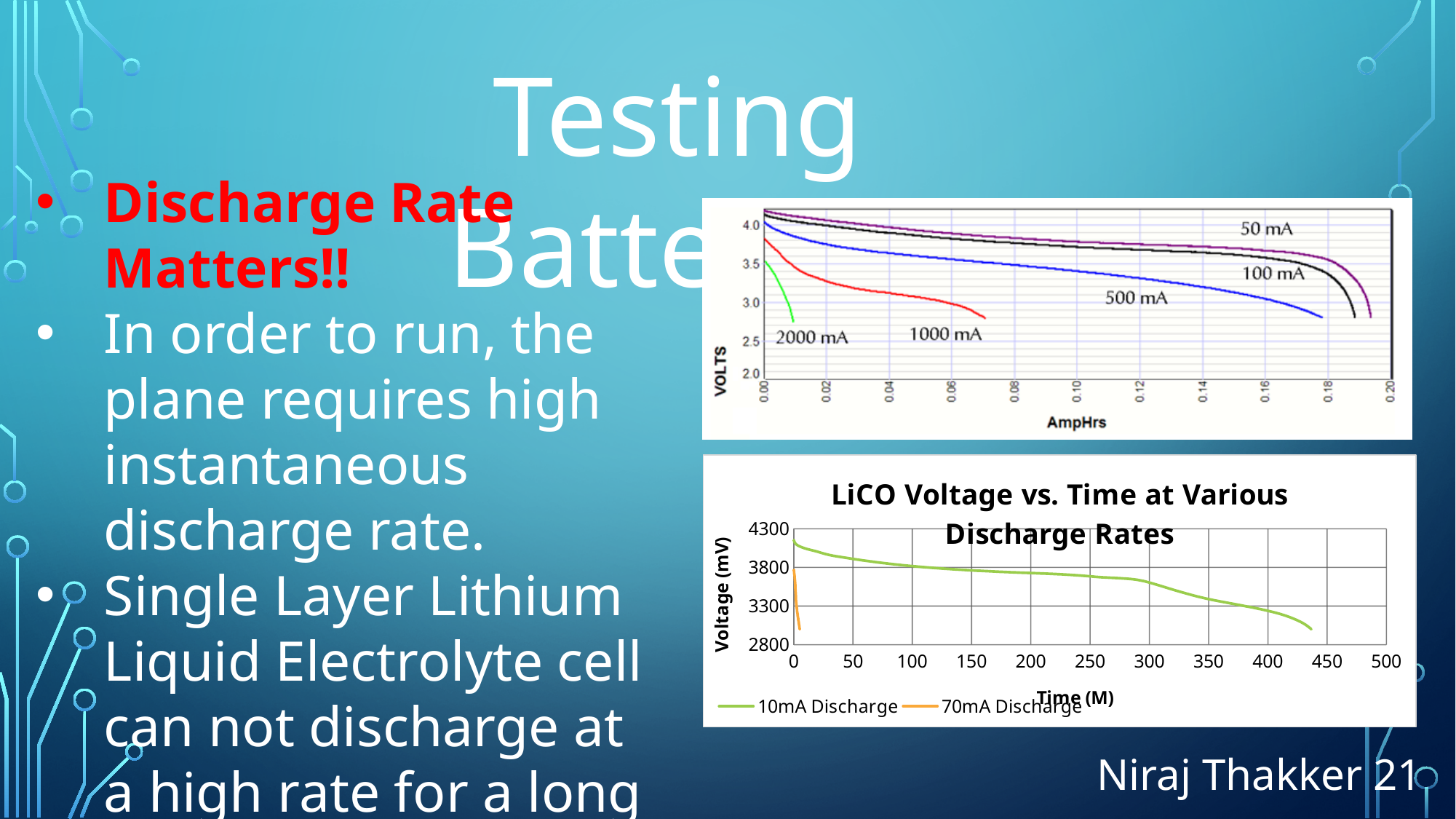
In the top chart (Volts vs AmpHrs), at 0.10 AmpHrs, which curve shows the higher voltage, 50 mA or 500 mA? 50 mA In the bottom chart 'LiCO Voltage vs. Time at Various Discharge Rates', does the 10mA Discharge voltage rise or fall as time increases? fall In the top chart (Volts vs AmpHrs), which discharge rate curve reaches the highest AmpHrs before dropping off? 50 mA In the top chart (Volts vs AmpHrs), which discharge rate curve drops off at the lowest AmpHrs? 2000 mA In the bottom chart 'LiCO Voltage vs. Time at Various Discharge Rates', which series lasts longer before its voltage drops off, 10mA Discharge or 70mA Discharge? 10mA Discharge In the bottom chart 'LiCO Voltage vs. Time at Various Discharge Rates', is the 10mA Discharge voltage at 300 minutes greater or less than 3300 mV? greater In the top chart (Volts vs AmpHrs), how many discharge-rate curves are plotted? 5 In the bottom chart 'LiCO Voltage vs. Time at Various Discharge Rates', is the 10mA Discharge voltage at time 0 greater or less than 3800 mV? greater How many series does the legend of the bottom chart 'LiCO Voltage vs. Time at Various Discharge Rates' list? 2 In the bottom chart 'LiCO Voltage vs. Time at Various Discharge Rates', what are the two series named in the legend? 10mA Discharge and 70mA Discharge What is the y-axis label of the bottom chart 'LiCO Voltage vs. Time at Various Discharge Rates'? Voltage (mV) What kind of chart is the bottom chart titled 'LiCO Voltage vs. Time at Various Discharge Rates'? line chart